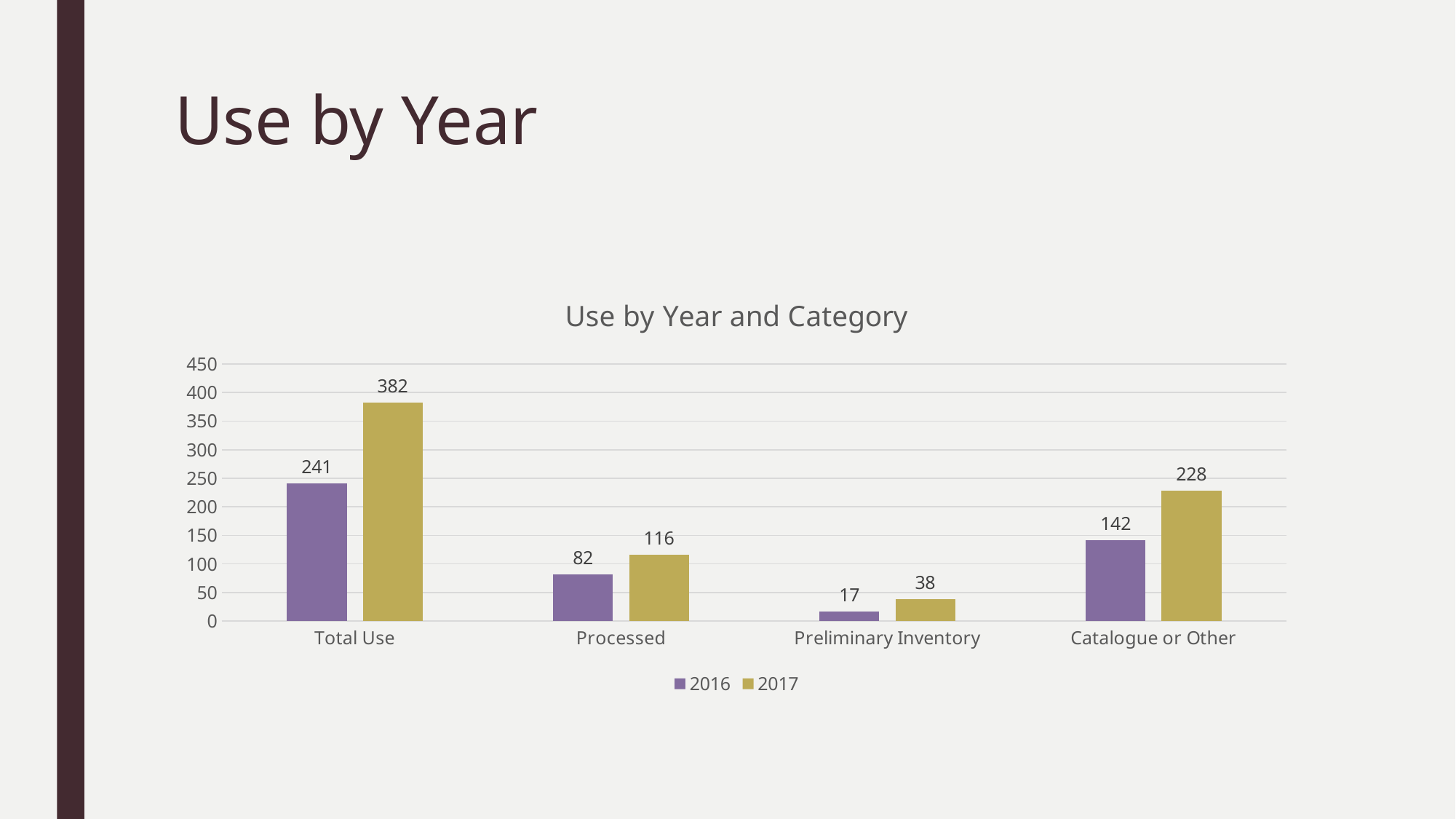
What is the difference between the 2017 and 2016 values for Catalogue or Other? 86 Which is larger for Processed: the 2016 value or the 2017 value? 2017 Which category has the highest value for 2017? Total Use How many series does the legend list? 2 What is the value for Total Use in 2017? 382 What is the value for Processed in 2016? 82 What is the value for Preliminary Inventory in 2017? 38 What is the difference between the 2017 and 2016 values for Total Use? 141 What type of chart is shown on the slide? Bar chart Which category has the lowest value for 2016? Preliminary Inventory How many categories are shown on the x axis? 4 What is the value for Catalogue or Other in 2016? 142